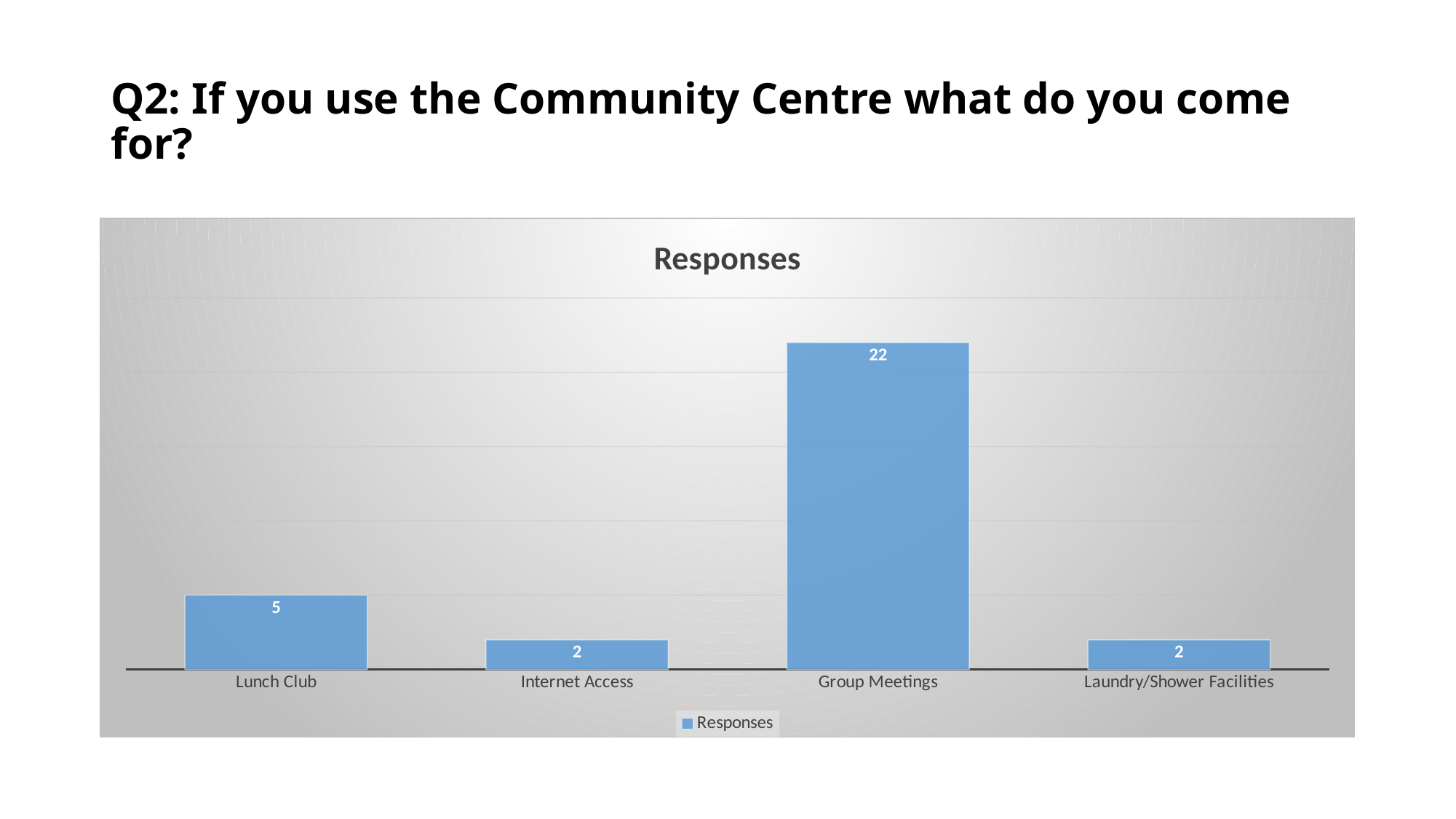
How many categories are shown on the x axis? 4 What is the value for Internet Access? 2 Which category has the highest number of responses? Group Meetings What kind of chart is shown on the slide? Bar chart How many series does the legend list? 1 What is the difference between the values for Lunch Club and Internet Access? 3 What is the value for Group Meetings? 22 What is the value for Laundry/Shower Facilities? 2 What is the value for Lunch Club? 5 Which is larger, the value for Lunch Club or the value for Laundry/Shower Facilities? Lunch Club What is the difference between the values for Group Meetings and Lunch Club? 17 What is the title of the chart? Responses